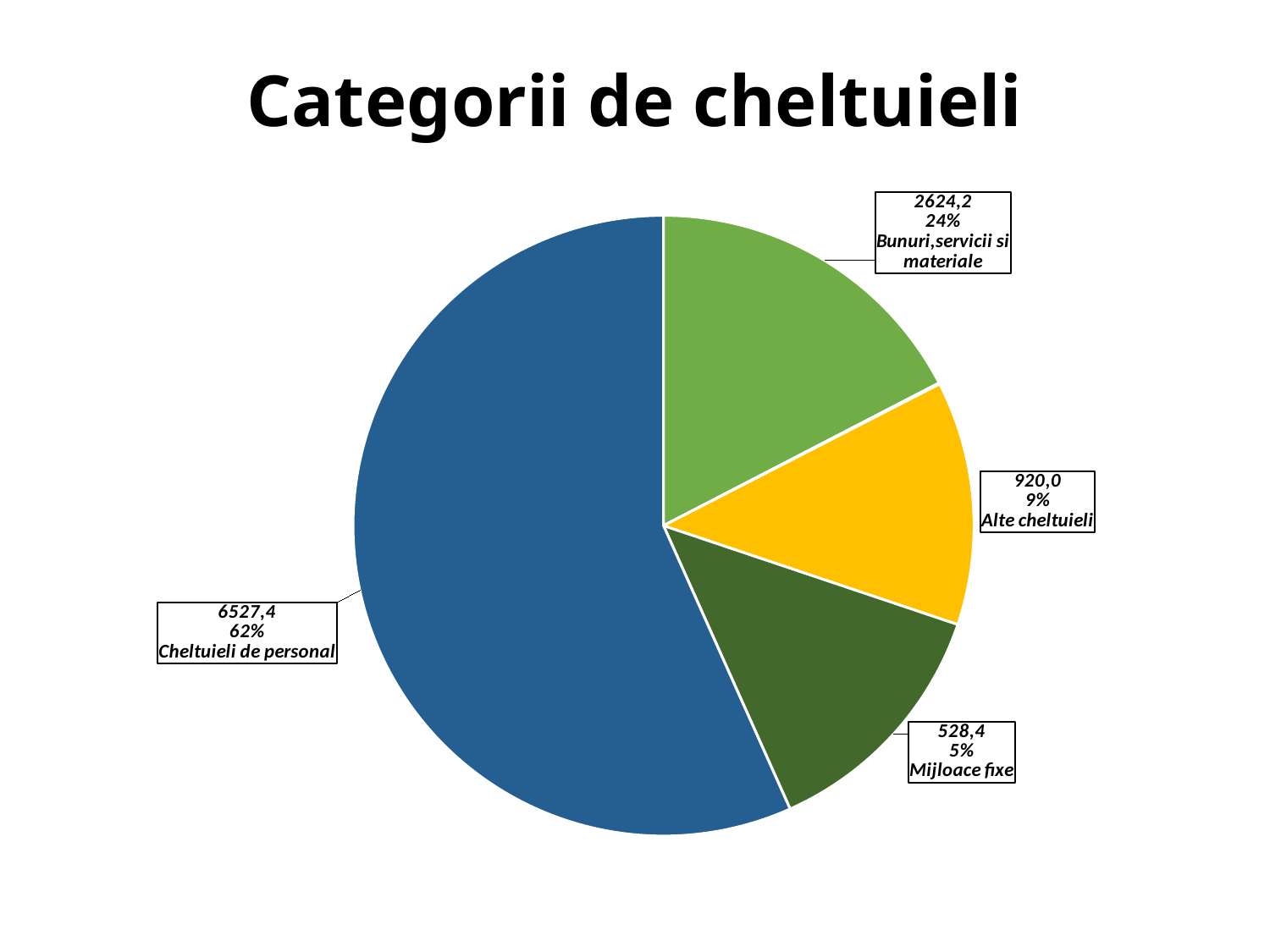
Which is larger, Alte cheltuieli or Mijloace fixe? Alte cheltuieli Which category has the largest slice? Cheltuieli de personal How many slices does the pie chart have? 4 What is the value for Cheltuieli de personal? 6527,4 What is the difference between the values for Cheltuieli de personal and Bunuri,servicii si materiale? 3903,2 What share of the pie does Cheltuieli de personal represent? 62% Which category has the smallest slice? Mijloace fixe What is the value for Bunuri,servicii si materiale? 2624,2 What kind of chart is shown on the slide? pie chart What share of the pie does Alte cheltuieli represent? 9% What is the title of the chart? Categorii de cheltuieli What is the value for Mijloace fixe? 528,4